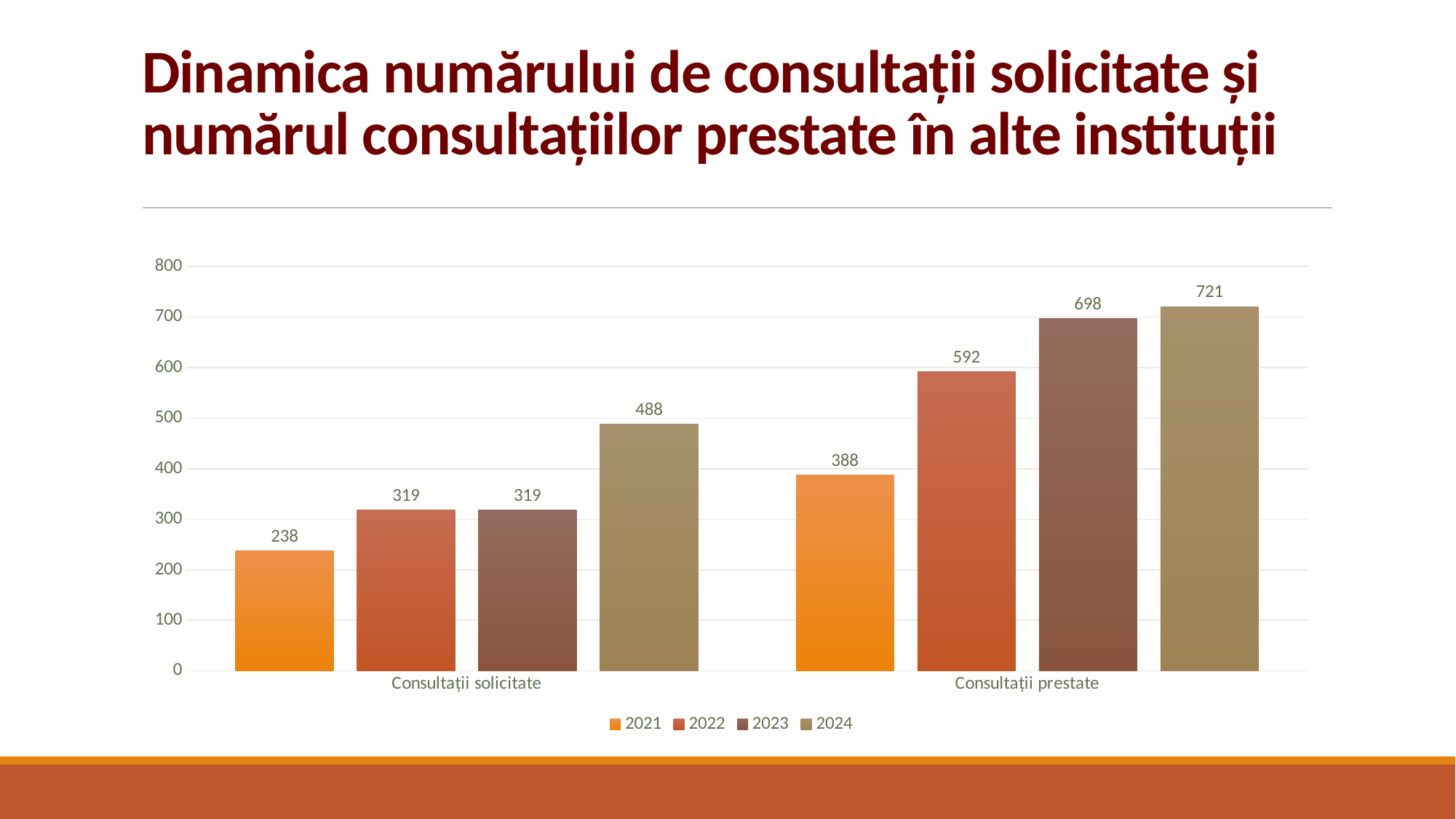
Do the values for Consultații prestate rise or fall from 2021 to 2024? Rise Which year has the highest value in the Consultații prestate category? 2024 What is the value for 2022 in the Consultații solicitate category? 319 What is the value for 2021 in the Consultații prestate category? 388 What kind of chart is shown on the slide? Bar chart Which is larger: the 2023 value for Consultații solicitate or the 2023 value for Consultații prestate? Consultații prestate What is the value for 2024 in the Consultații solicitate category? 488 What is the difference between the 2024 and 2021 values in the Consultații prestate category? 333 How many series does the legend list? 4 What is the difference between the 2024 and 2023 values in the Consultații solicitate category? 169 Which year has the lowest value in the Consultații solicitate category? 2021 How many categories are shown on the x axis? 2